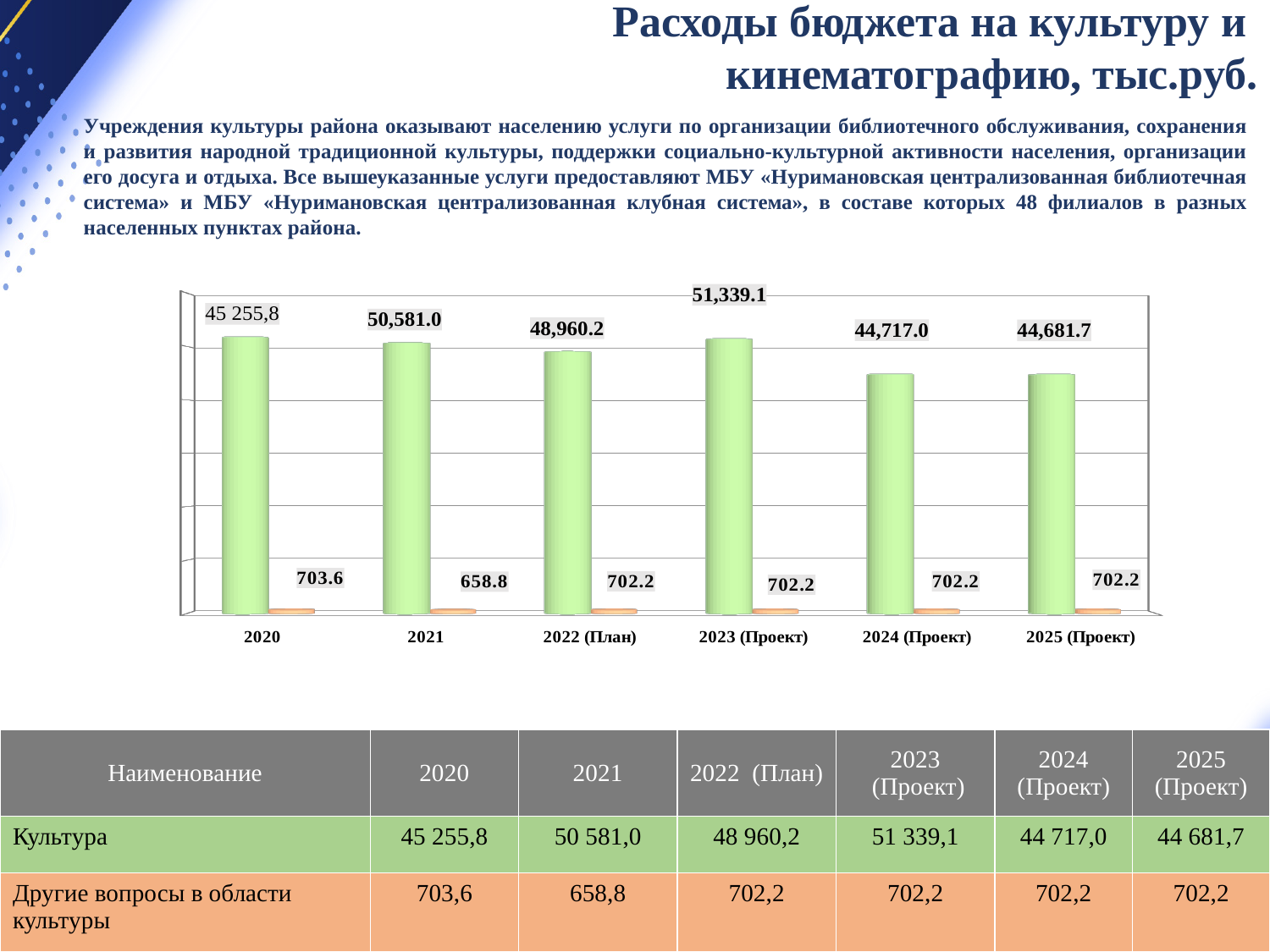
Which year has the lowest orange bar on the chart? 2021 What is the value of the green bar for 2021 on the chart? 50,581.0 Which is larger on the chart: the green bar for 2022 (План) or the green bar for 2024 (Проект)? 2022 (План) What is the difference between the green bar values for 2023 (Проект) and 2021? 758.1 What is the difference between the orange bar values for 2020 and 2021? 44.8 What is the value of the orange bar for 2020 on the chart? 703.6 Which year has the lowest green bar on the chart? 2025 (Проект) What is the value of the green bar for 2023 (Проект) on the chart? 51,339.1 What type of chart is shown on the slide? Bar chart What is the value of the orange bar for 2021 on the chart? 658.8 How many year categories are shown on the x axis of the chart? 6